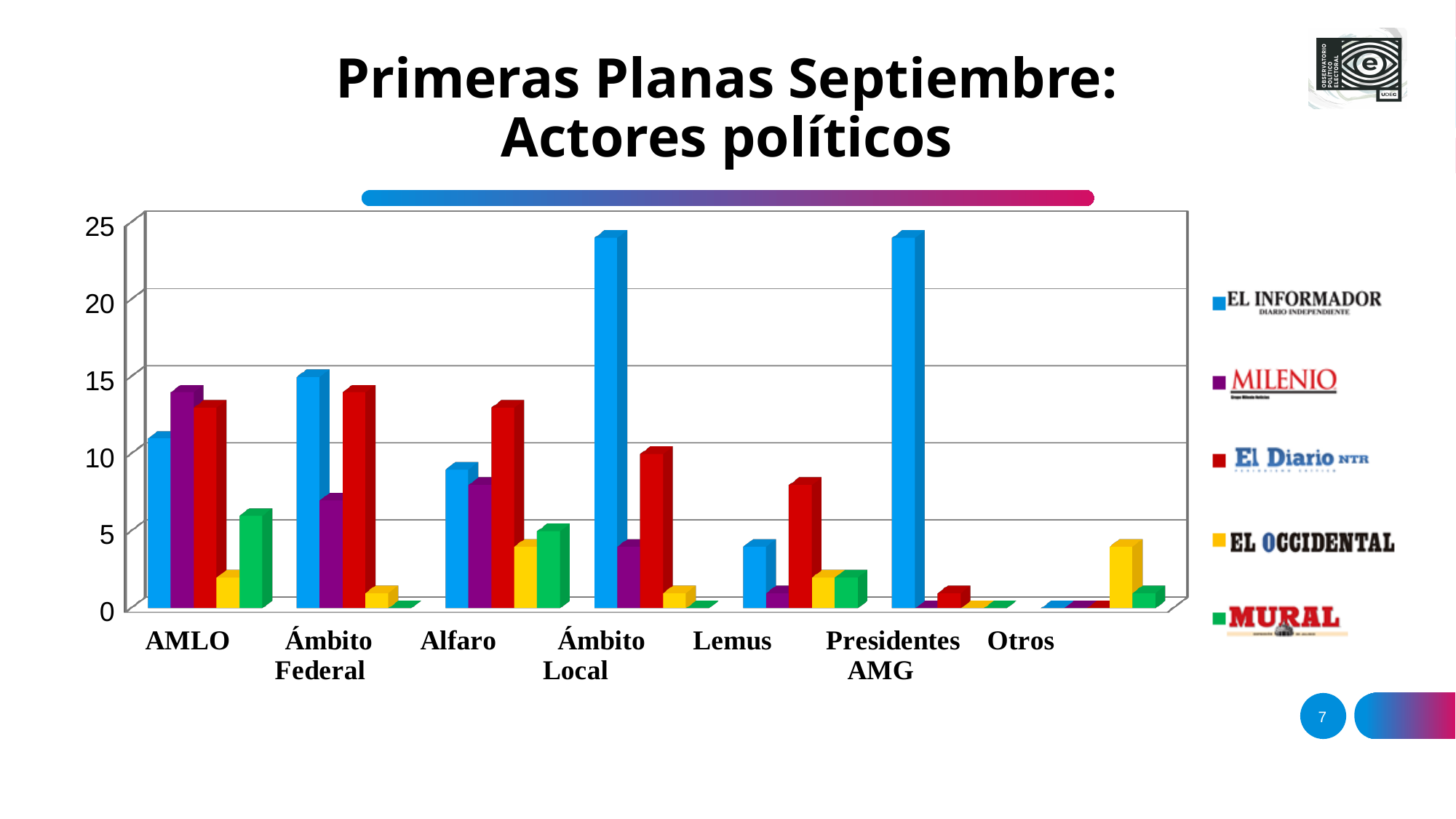
Which newspaper has the highest value in the Otros category? El Occidental In the Alfaro category, which is larger: the value for El Diario NTR or the value for Milenio? El Diario NTR Is the value for El Informador in the Ámbito Local category greater or less than 20? greater Which newspaper has the highest value in the Lemus category? El Diario NTR What is the title of the chart on the slide? Primeras Planas Septiembre: Actores políticos How many categories are shown along the x axis of the chart? 7 Is the value for El Diario NTR in the Lemus category greater or less than 5? greater Is the value for Milenio in the AMLO category greater or less than 10? greater Which newspaper has the highest value in the Ámbito Federal category? El Informador How many series does the chart's legend list? 5 What kind of chart is shown on the slide? bar chart